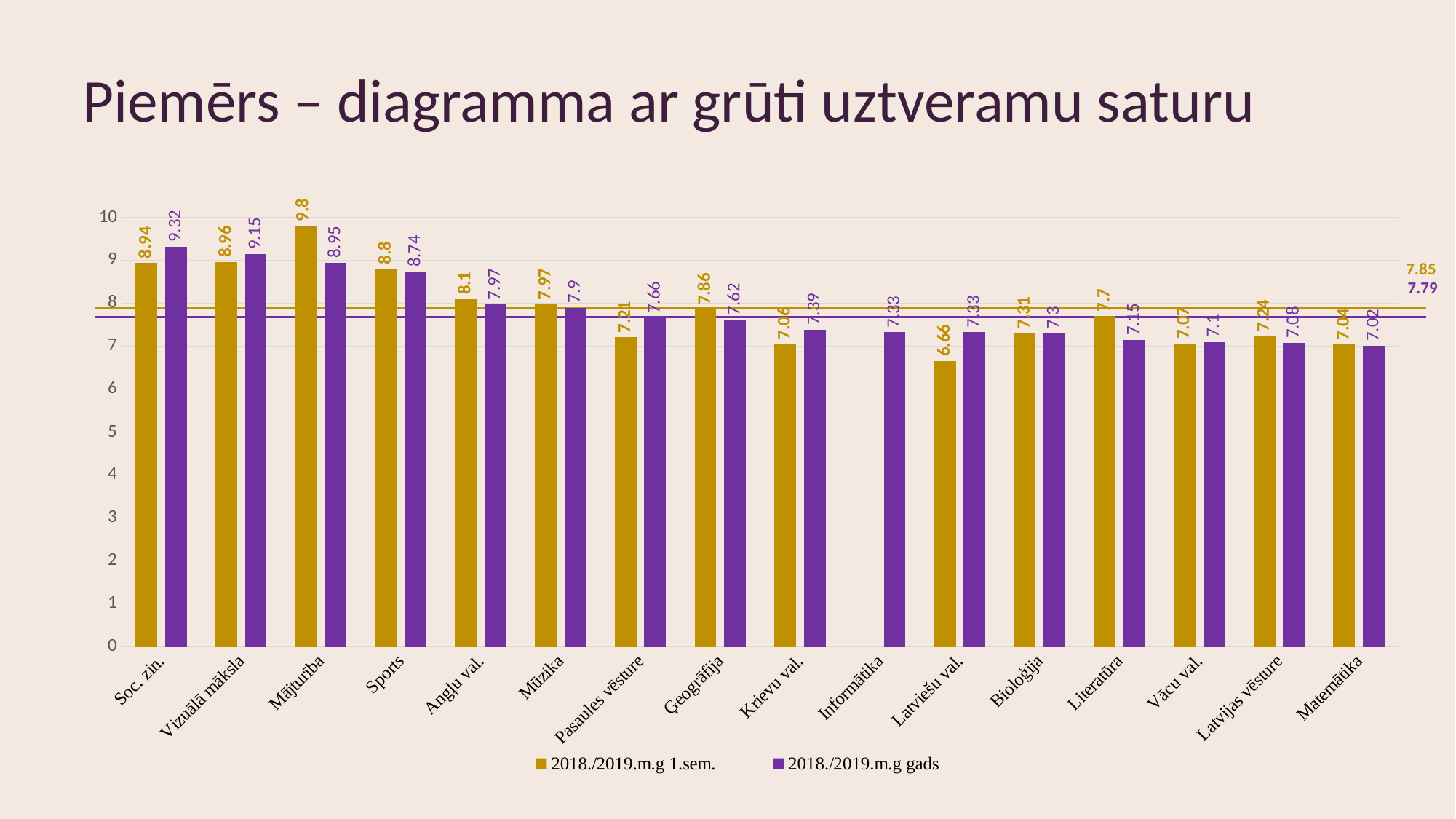
What is the value for Mājturība in the 2018./2019.m.g 1.sem. series? 9.8 How many series does the legend list? 2 Is the 2018./2019.m.g gads value for Krievu val. greater or less than 8? less Which is larger for Literatūra: the 2018./2019.m.g 1.sem. value or the 2018./2019.m.g gads value? 2018./2019.m.g 1.sem. Which category has the lowest value in the 2018./2019.m.g gads series? Matemātika What value is labelled on the gold horizontal line at the right edge of the chart? 7.85 What is the difference between the 2018./2019.m.g gads value and the 2018./2019.m.g 1.sem. value for Pasaules vēsture? 0.45 What is the value for Soc. zin. in the 2018./2019.m.g gads series? 9.32 What kind of chart is shown on the slide? bar chart How many categories are shown on the x axis? 16 Which category has the highest value in the 2018./2019.m.g 1.sem. series? Mājturība What is the value for Latviešu val. in the 2018./2019.m.g 1.sem. series? 6.66